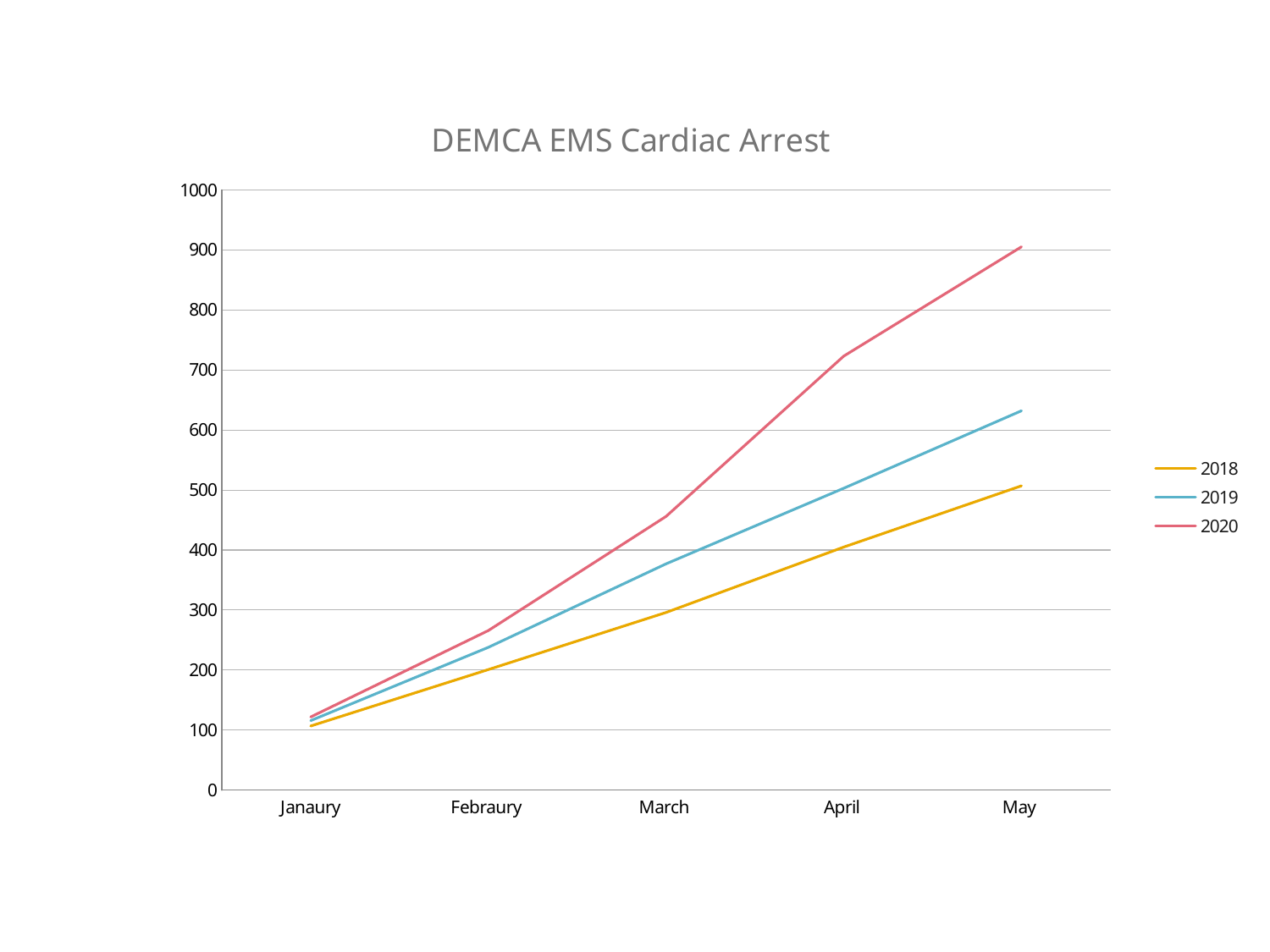
What kind of chart is shown on the slide? Line chart Which series has the highest value in May? 2020 How many months are shown on the x axis? 5 Is the value for 2020 in May greater or less than 800? greater How many series does the legend list? 3 In April, which series is larger, 2019 or 2018? 2019 What is the title of the chart? DEMCA EMS Cardiac Arrest Is the value for 2018 in May greater or less than 600? less Is the value for 2019 in May greater or less than 600? greater In which month is the 2018 series at its lowest? Janaury Do the values for the 2020 series rise or fall from Janaury to May? rise